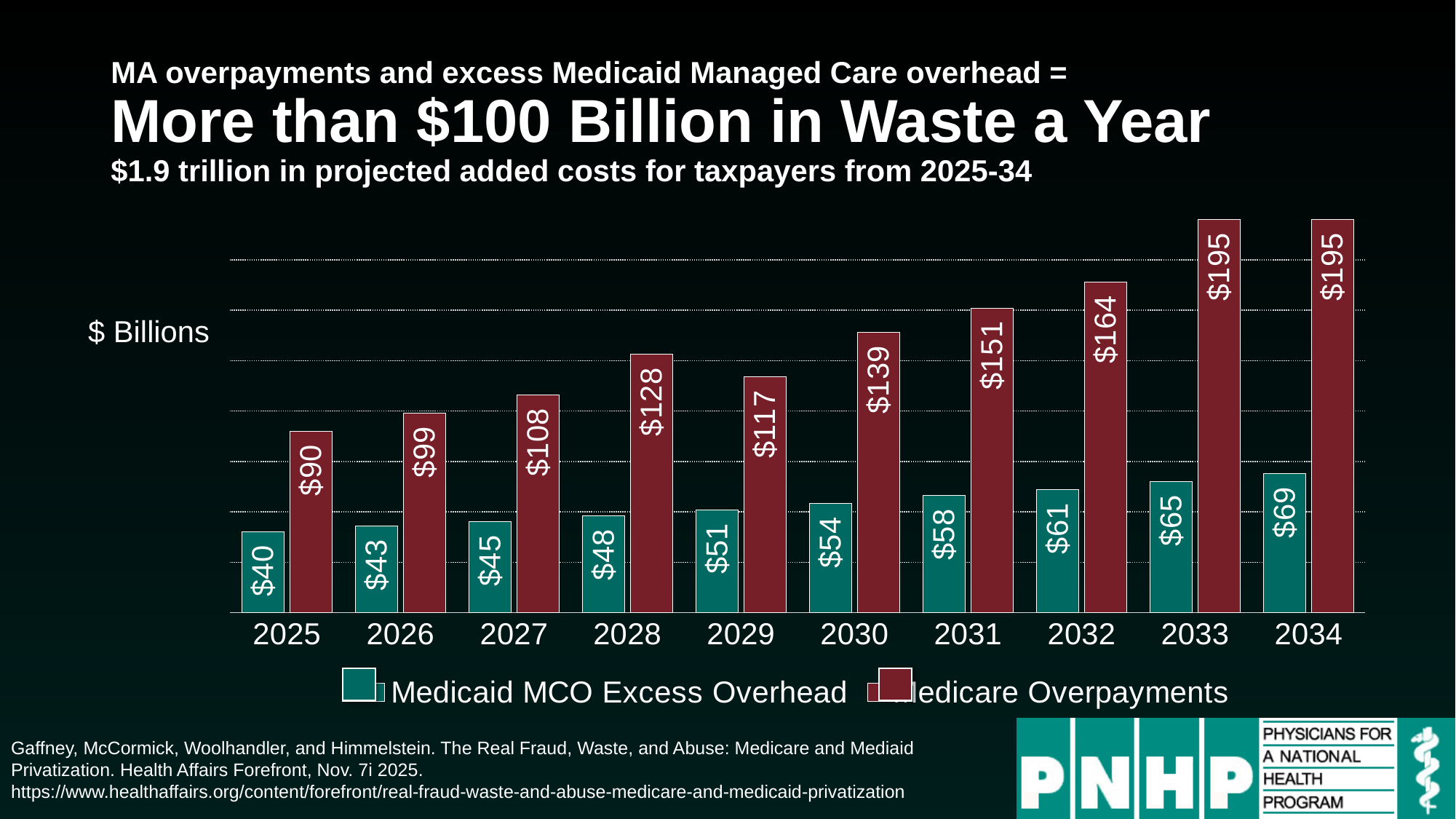
How many series does the legend list? 2 What is the difference between Medicare Overpayments in 2034 and in 2025? $105 What is the value for Medicaid MCO Excess Overhead in 2031? $58 Do the Medicaid MCO Excess Overhead values rise or fall from 2025 to 2034? Rise What is the difference between Medicare Overpayments and Medicaid MCO Excess Overhead in 2030? $85 Which year has the lowest value for Medicaid MCO Excess Overhead? 2025 How many years are shown on the x axis of the chart? 10 What is the value for Medicare Overpayments in 2025? $90 Which is larger: Medicaid MCO Excess Overhead in 2034 or Medicare Overpayments in 2025? Medicare Overpayments in 2025 Which year has the highest value for Medicare Overpayments in the chart? 2033 and 2034 What kind of chart is shown on the slide? Bar chart What is the value for Medicare Overpayments in 2028? $128